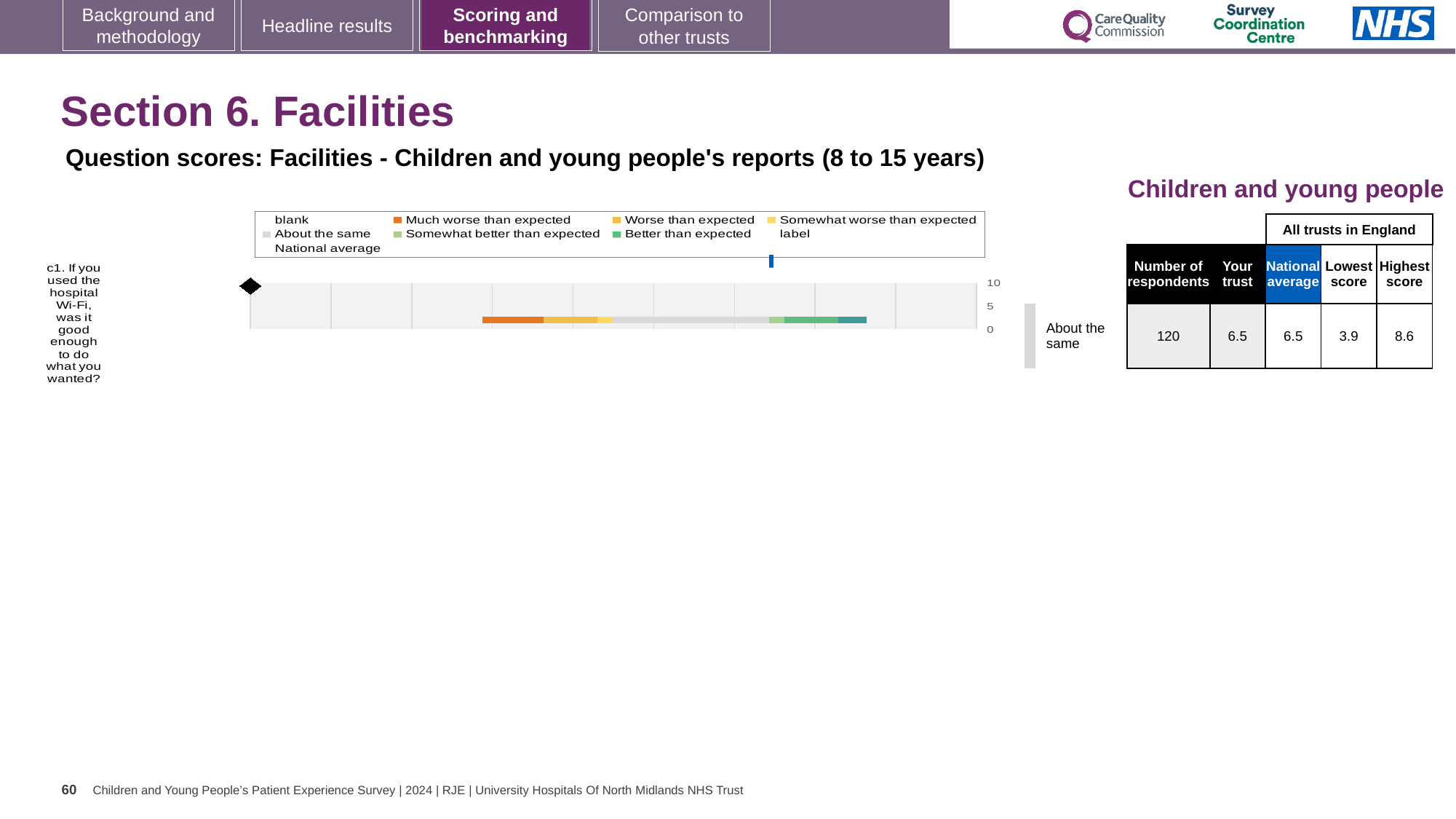
Is the Your trust score for question c1 larger than the National average, or are they equal? equal What is the 'Your trust' score for question c1 in the table? 6.5 What kind of chart is shown on the slide? bar chart What is the Lowest score among all trusts in England for question c1? 3.9 What is the Highest score among all trusts in England for question c1? 8.6 What benchmark category is question c1 assigned to? About the same What is the difference between the Highest score and the Lowest score for question c1? 4.7 What is the highest value shown on the chart's axis? 10 What is the National average score for question c1 in the table? 6.5 Which legend entry is shown in orange? Much worse than expected How many respondents answered question c1? 120 How many survey questions (categories) are plotted in the chart? 1